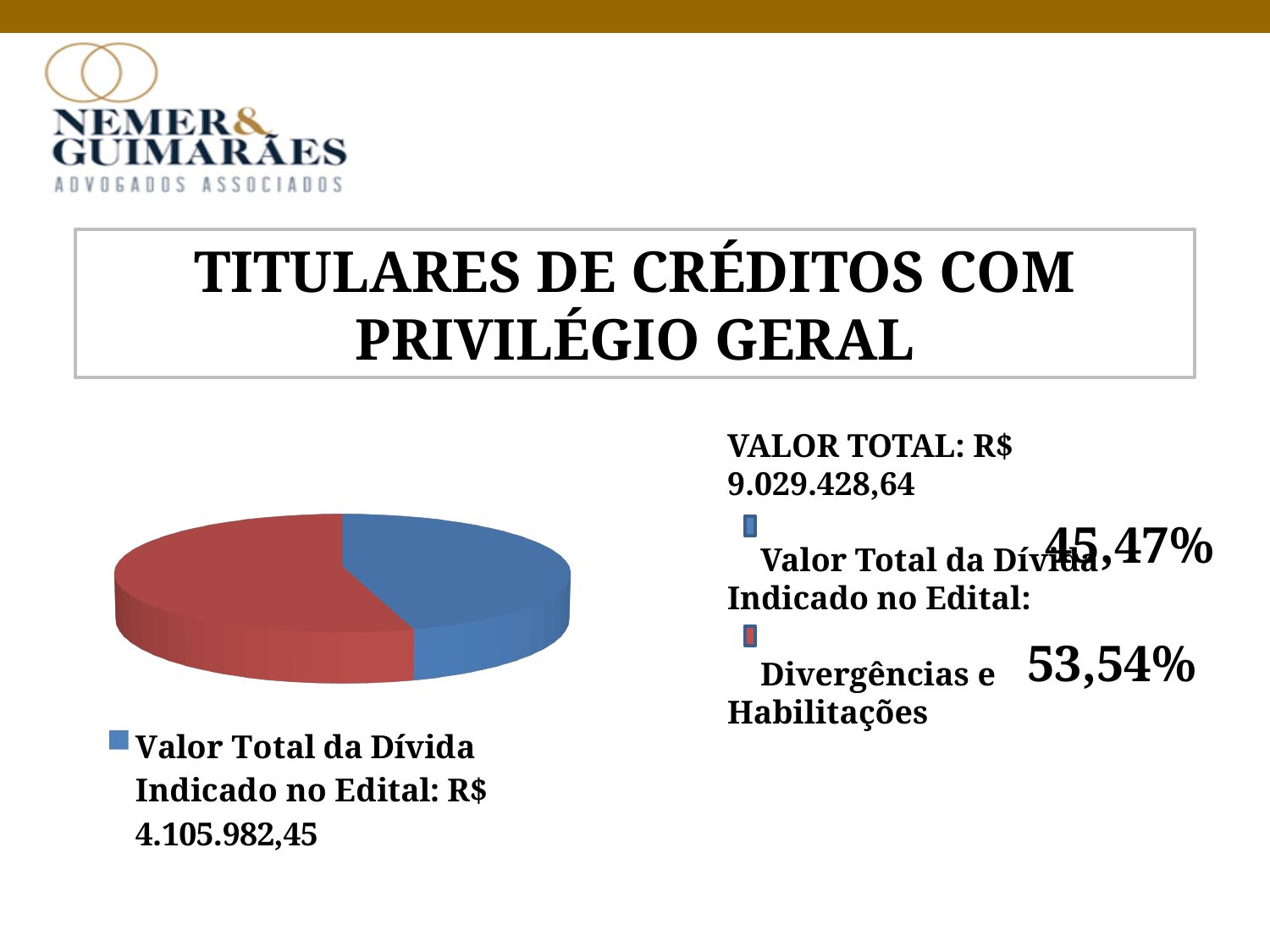
Which slice of the pie chart is the largest? Divergências e Habilitações Which slice of the pie chart is the smallest? Valor Total da Dívida Indicado no Edital What percentage share is shown for "Divergências e Habilitações"? 53,54% Which is larger: the share for "Divergências e Habilitações" or the share for "Valor Total da Dívida Indicado no Edital"? Divergências e Habilitações How many slices does the pie chart have? 2 What kind of chart is shown on the slide? pie chart What colour is the "Divergências e Habilitações" slice of the pie chart? red What is the "VALOR TOTAL" stated next to the pie chart? R$ 9.029.428,64 What percentage share is shown for "Valor Total da Dívida Indicado no Edital"? 45,47% What is the title of the slide containing the pie chart? TITULARES DE CRÉDITOS COM PRIVILÉGIO GERAL What value in R$ is given in the legend for "Valor Total da Dívida Indicado no Edital"? R$ 4.105.982,45